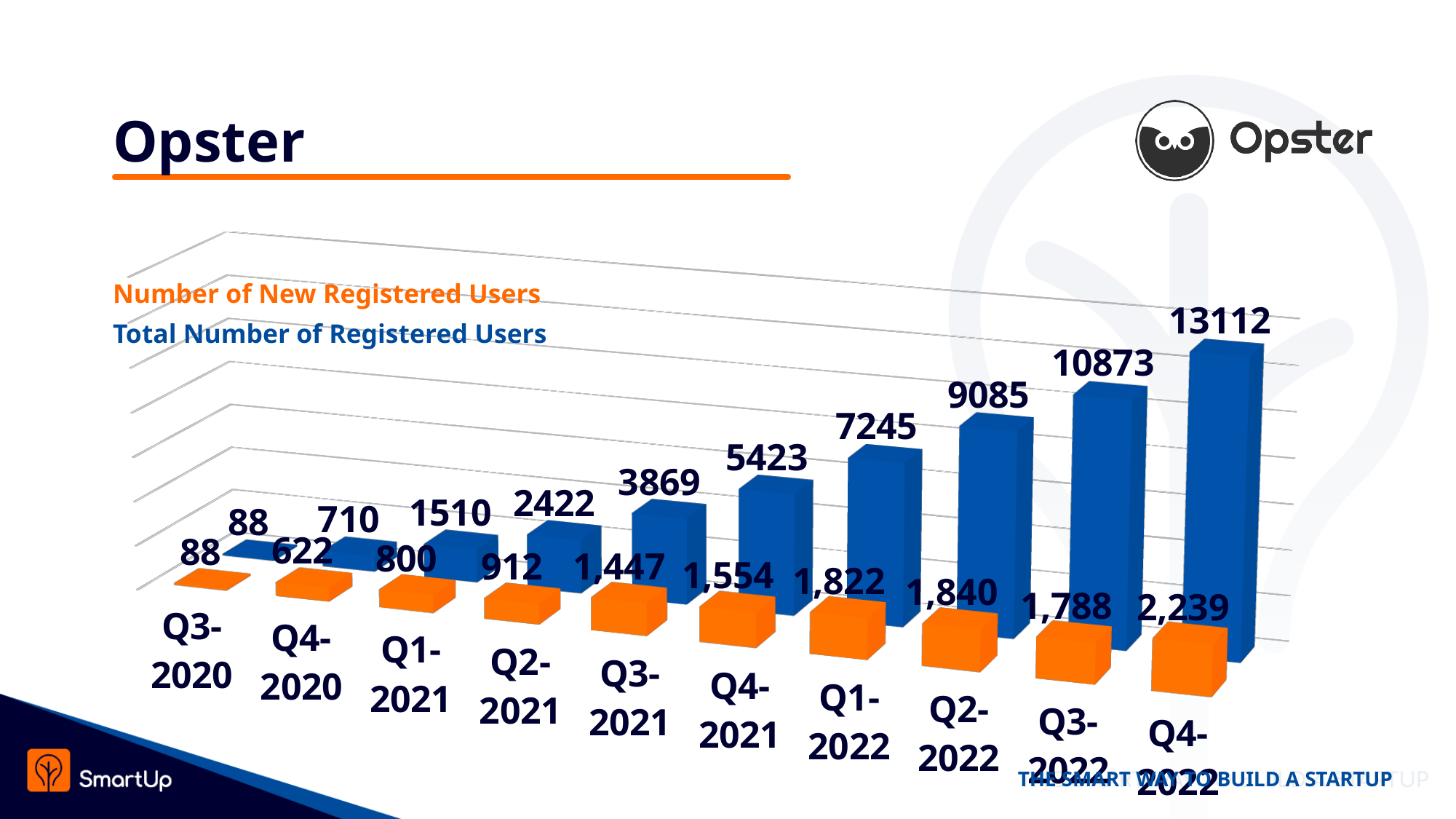
How many series does the legend list? 2 Which is larger: the Number of New Registered Users in Q1-2022 or in Q3-2022? Q1-2022 What is the difference in Total Number of Registered Users between Q4-2022 and Q3-2022? 2239 Do the Total Number of Registered Users values rise or fall from Q3-2020 to Q4-2022? rise What is the Total Number of Registered Users for Q2-2021? 2422 Which colour represents the Number of New Registered Users series? orange Which quarter has the lowest Total Number of Registered Users? Q3-2020 How many quarters are shown on the x axis? 10 What is the Number of New Registered Users for Q3-2021? 1,447 What is the Total Number of Registered Users for Q4-2022? 13112 Which quarter has the highest Number of New Registered Users? Q4-2022 What kind of chart is shown on the slide? bar chart